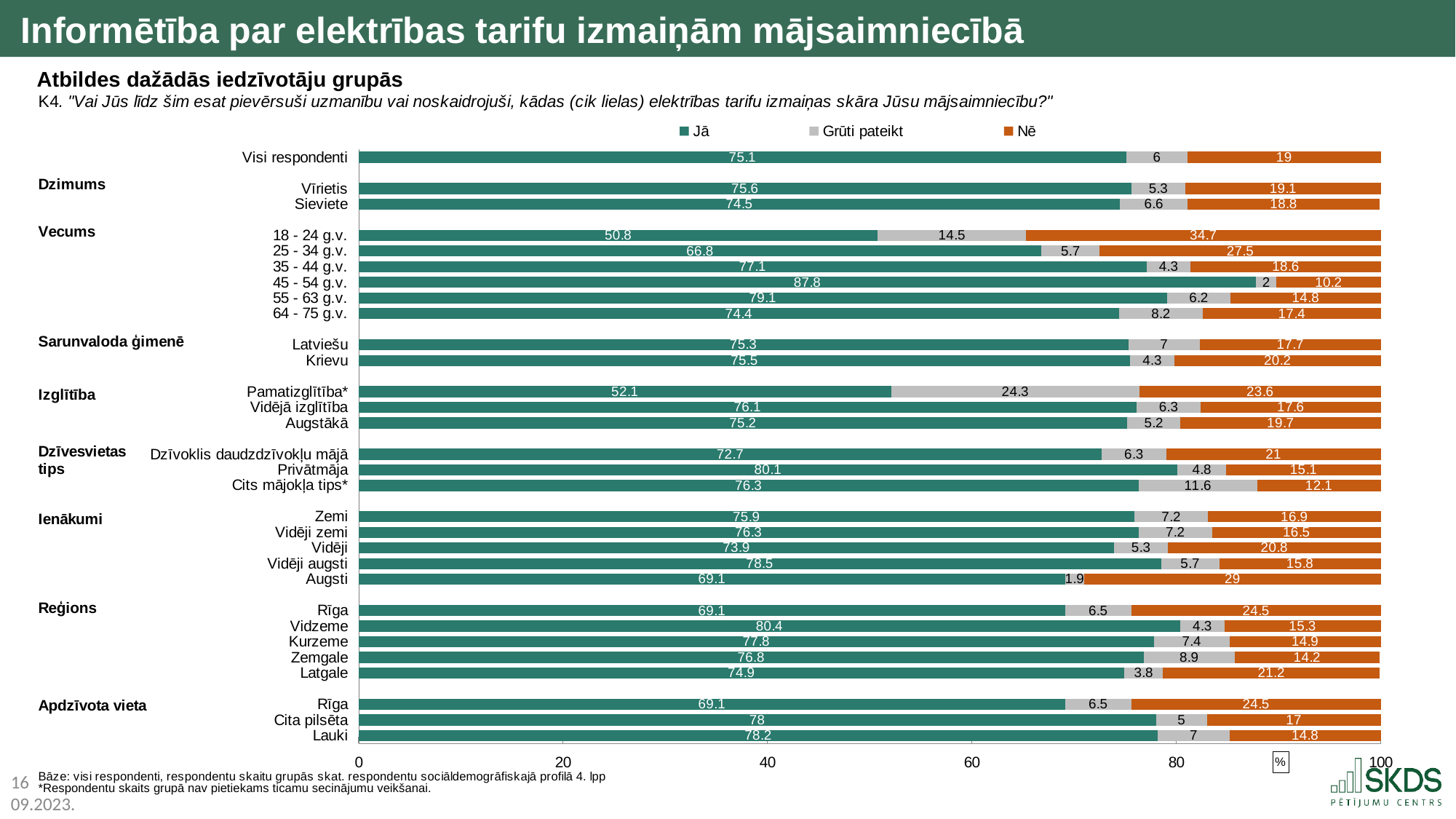
Which age group (Vecums) has the lowest "Jā" value? 18 - 24 g.v. What is the difference between the "Nē" values for 18 - 24 g.v. and 45 - 54 g.v.? 24.5 What percentage of all respondents (Visi respondenti) answered "Jā"? 75.1 Is the "Jā" value for Augsti (Ienākumi) greater or less than 60? greater What is the "Nē" value for the 18 - 24 g.v. age group? 34.7 Which has a larger "Jā" value, Privātmāja or Dzīvoklis daudzdzīvokļu mājā? Privātmāja What is the total of the stacked bar for 45 - 54 g.v.? 100 What is the "Grūti pateikt" value for Pamatizglītība*? 24.3 Which region (Reģions) has the highest "Nē" value? Rīga Which age group (Vecums) has the highest "Jā" value? 45 - 54 g.v. How many series does the legend list? 3 What type of chart is shown on the slide? Stacked bar chart